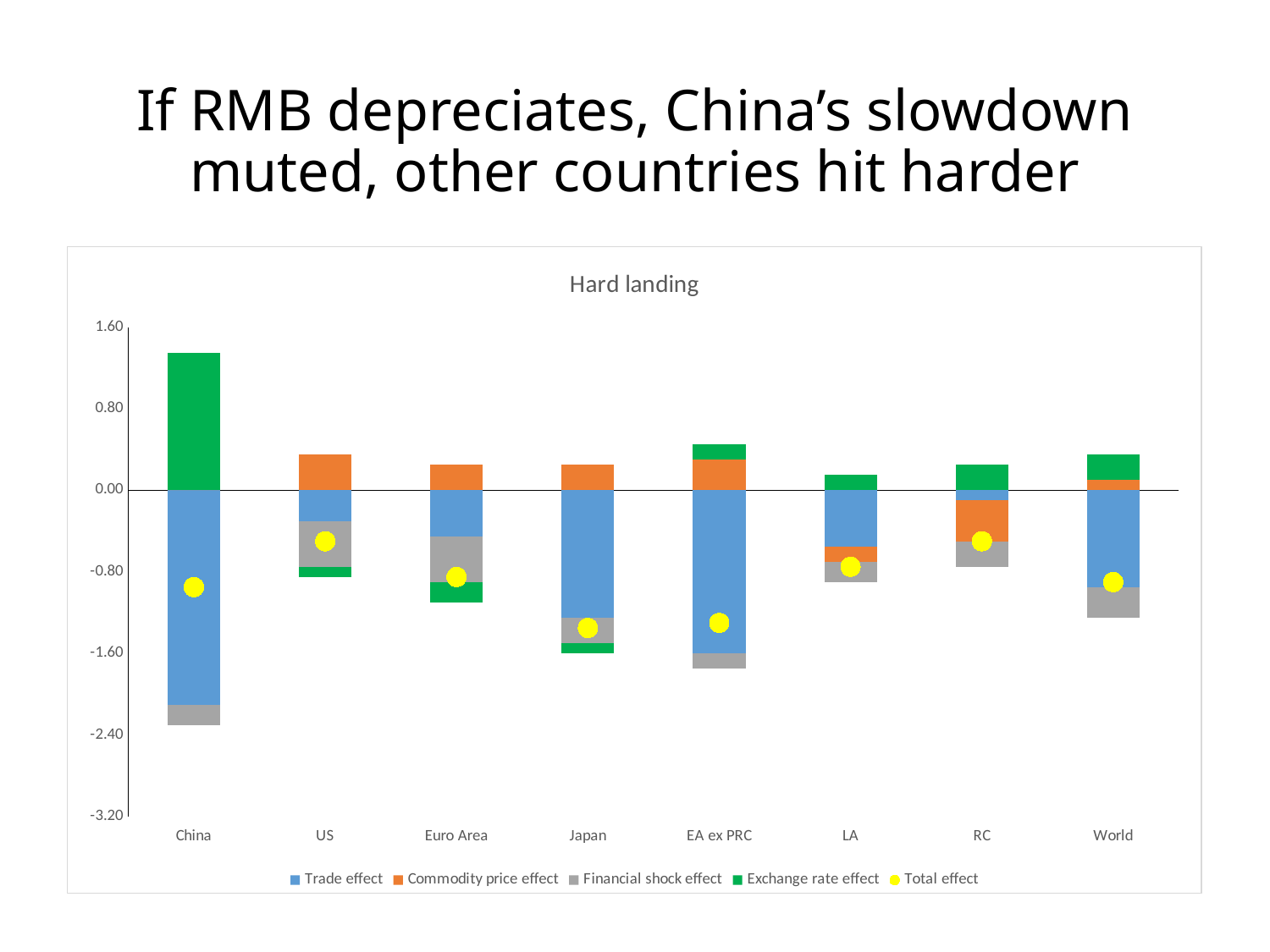
Which category has the most negative Trade effect? China Which series is plotted as yellow markers rather than stacked bars? Total effect Is the Trade effect value for China greater or less than -1.60? less Which category has the largest positive Exchange rate effect? China Which has the lower Total effect, Japan or US? Japan How many series does the chart's legend list? 5 Is the Exchange rate effect value for China greater or less than 0.80? greater How many categories are shown on the x axis of the chart? 8 Is the Total effect value for Japan greater or less than -0.80? less What is the title of the chart? Hard landing What type of chart is shown on the slide? Stacked bar chart